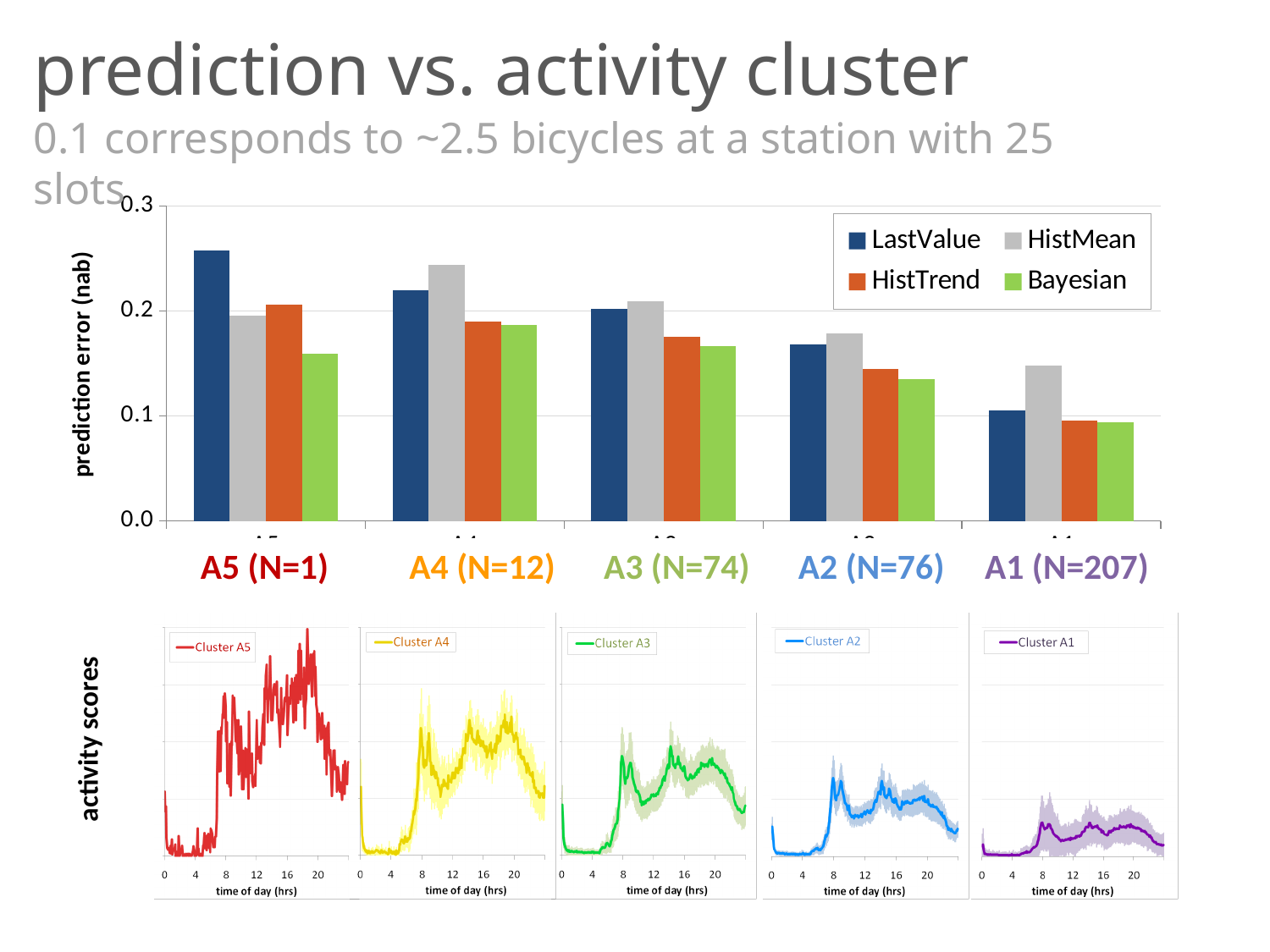
What kind of chart is the prediction error chart at the top of the slide? bar chart In the prediction error bar chart, does the LastValue error rise or fall going from A5 to A1 along the x axis? fall In the prediction error bar chart, is the LastValue error for A5 greater or less than 0.2? greater In the prediction error bar chart, how many activity clusters are shown on the x axis? 5 In the prediction error bar chart, is the Bayesian error for A5 greater or less than 0.2? less In the prediction error bar chart, which method has the highest error for cluster A4? HistMean What is the y-axis label of the prediction error bar chart? prediction error (nab) In the prediction error bar chart, how many series does the legend list? 4 In the prediction error bar chart, which method has the highest error for cluster A5? LastValue In the prediction error bar chart, is the HistMean error for A1 greater or less than 0.1? greater In the prediction error bar chart, is the LastValue error larger for A5 or for A1? A5 In the prediction error bar chart, which method has the lowest error for cluster A5? Bayesian